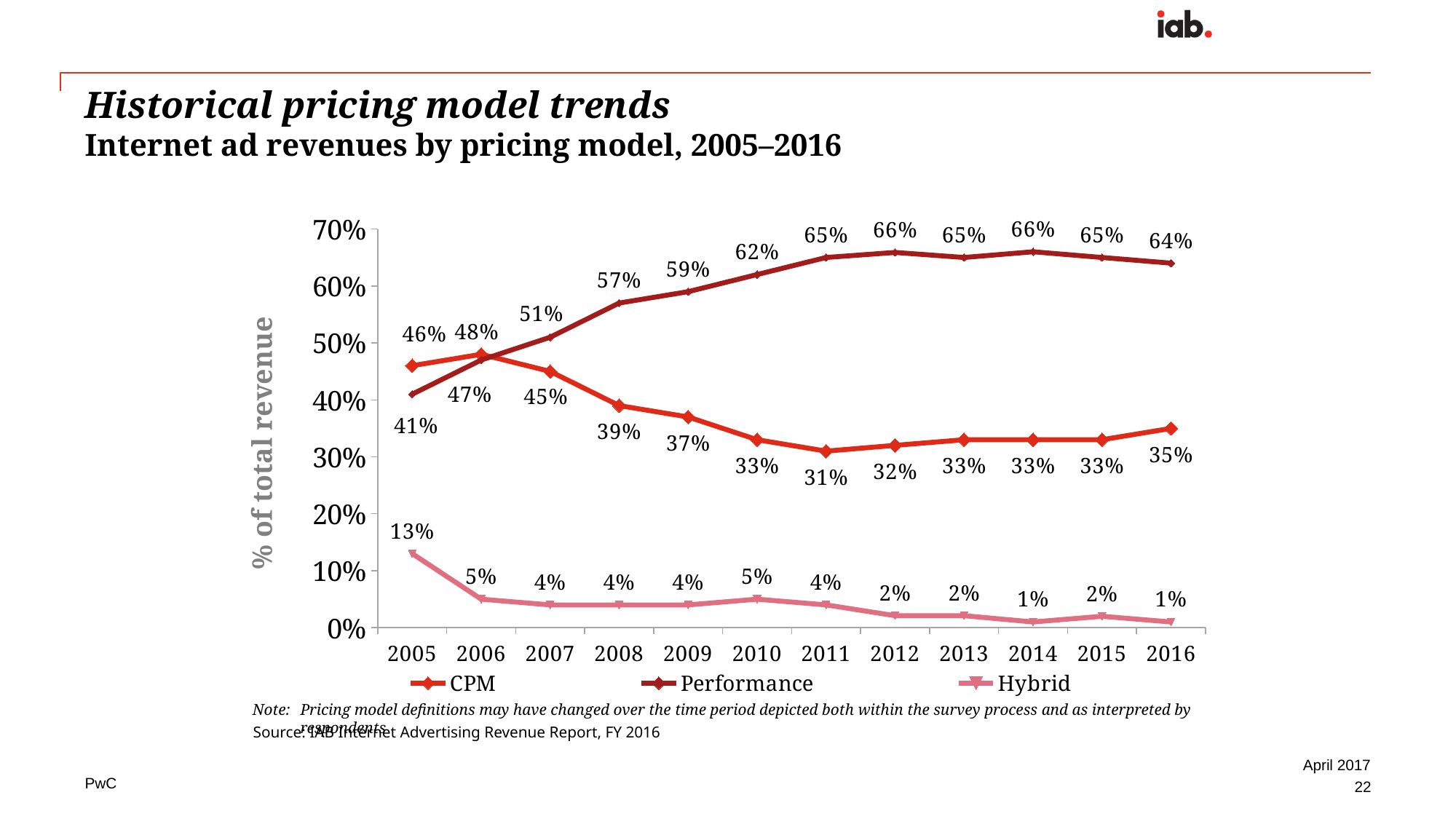
In which year did the CPM series reach its lowest value? 2011 What is the difference between the Performance and CPM shares in 2016? 29 percentage points What was the Hybrid share of total revenue in 2005? 13% Which was larger in 2005, the CPM share or the Performance share? CPM How many years are shown on the x axis? 12 What was the CPM share of total revenue in 2011? 31% What kind of chart is shown on the slide? Line chart In which year did the CPM series reach its highest value? 2006 What was the Performance share of total revenue in 2016? 64% What is the label of the y axis? % of total revenue Does the Performance series generally rise or fall from 2005 to 2016? Rise How many series does the legend list? 3